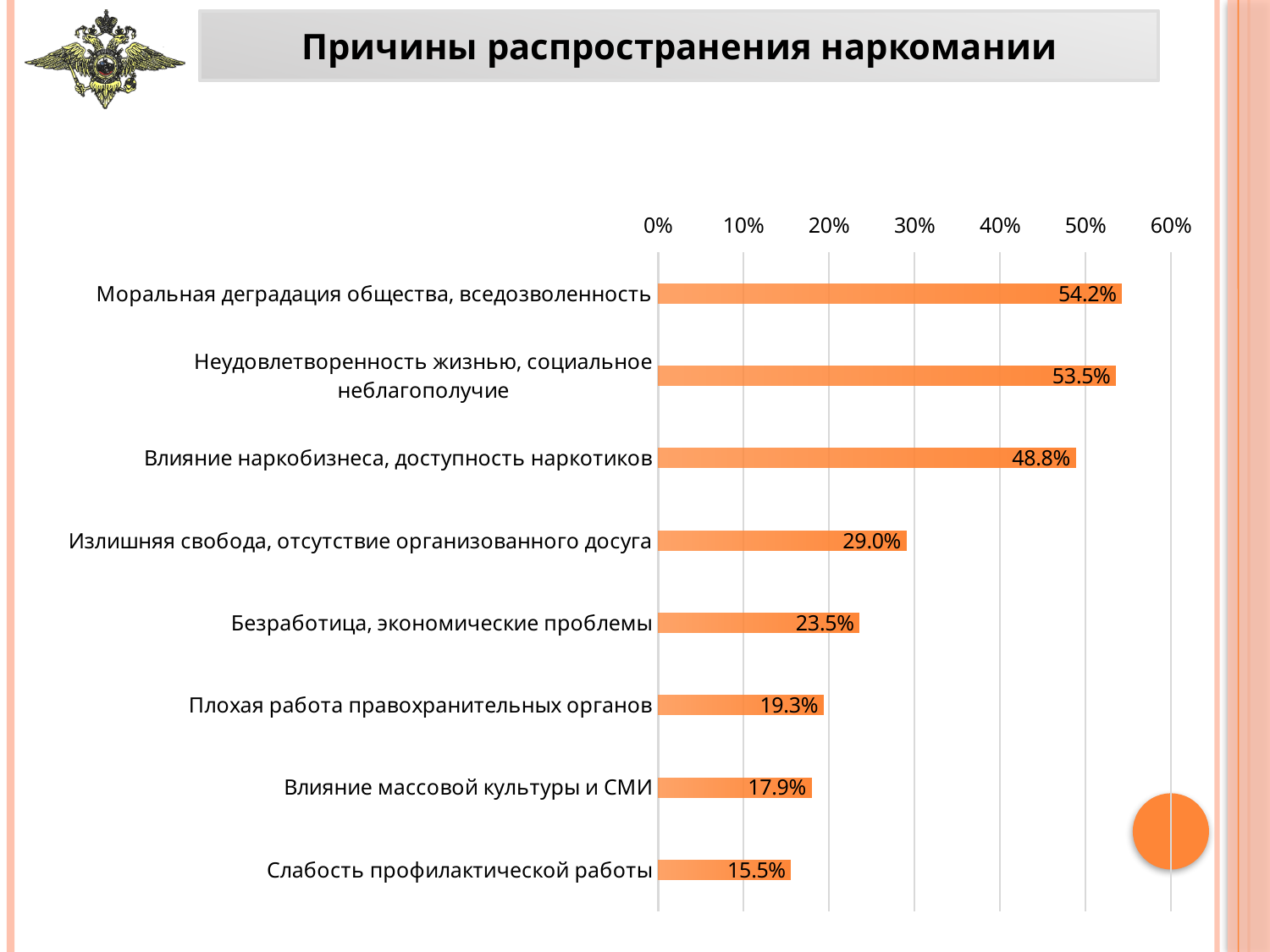
What is the total of «Слабость профилактической работы» and «Влияние массовой культуры и СМИ»? 33.4% What is the value for «Безработица, экономические проблемы»? 23.5% Which is larger: «Плохая работа правохранительных органов» or «Безработица, экономические проблемы»? Безработица, экономические проблемы What is the title of the slide? Причины распространения наркомании What is the value for «Влияние массовой культуры и СМИ»? 17.9% Which category has the lowest value? Слабость профилактической работы What is the difference between «Влияние наркобизнеса, доступность наркотиков» and «Излишняя свобода, отсутствие организованного досуга»? 19.8% Is the value for «Неудовлетворенность жизнью, социальное неблагополучие» greater or less than 50%? greater Which category has the highest value? Моральная деградация общества, вседозволенность What is the value for «Моральная деградация общества, вседозволенность»? 54.2% What kind of chart is shown on the slide? bar chart How many categories are shown in the chart? 8